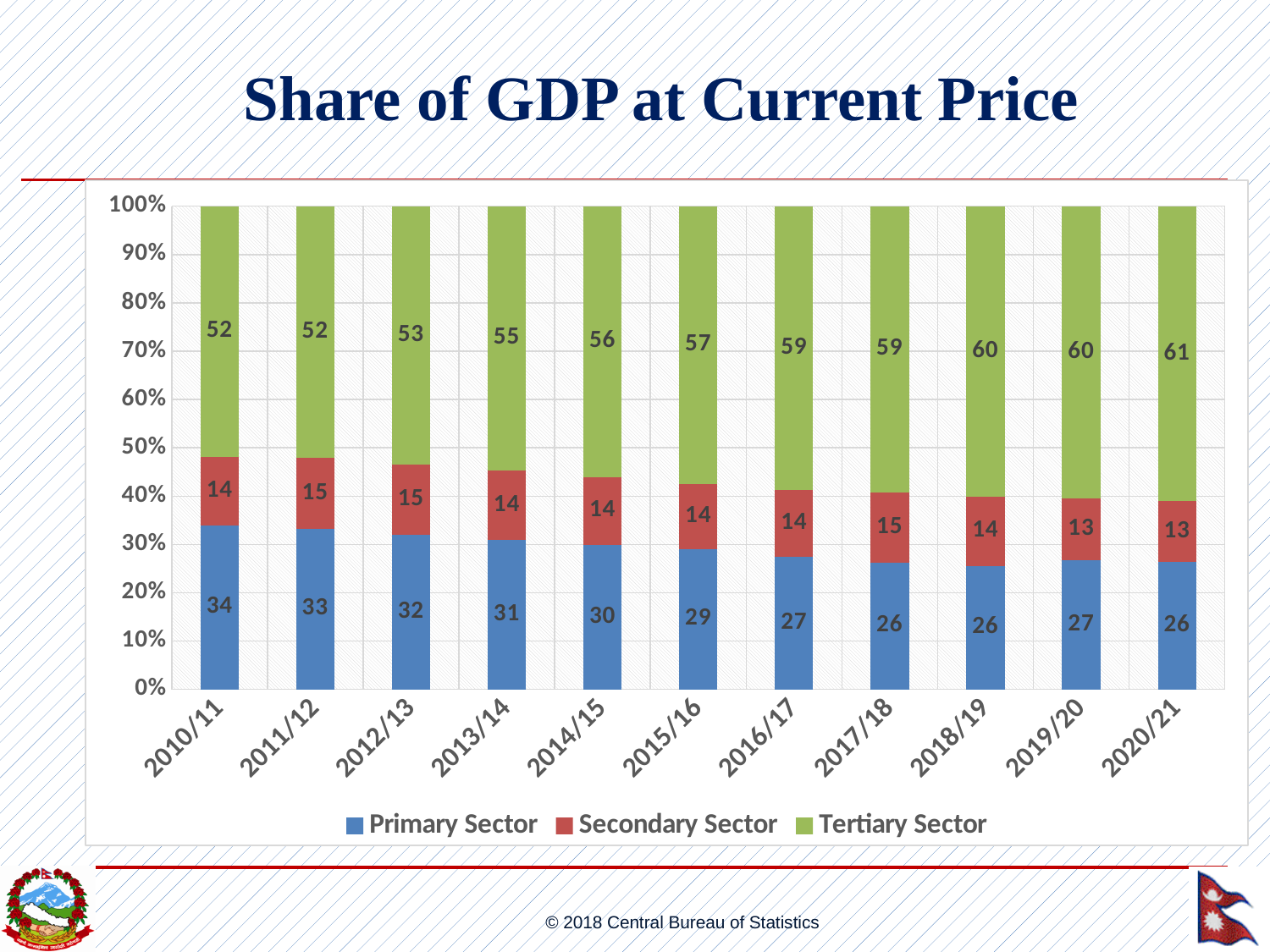
What is the title of the chart? Share of GDP at Current Price What kind of chart is shown on the slide? Stacked bar chart What is the difference between the Tertiary Sector values for 2020/21 and 2010/11? 9 In which year is the Primary Sector value highest? 2010/11 In which year is the Tertiary Sector value highest? 2020/21 How many years are shown on the x axis? 11 What is the Primary Sector value for 2010/11? 34 What is the Tertiary Sector value for 2020/21? 61 What is the Secondary Sector value for 2017/18? 15 How many series does the legend list? 3 Which is larger, the Primary Sector value for 2010/11 or for 2020/21? 2010/11 Does the Tertiary Sector value rise or fall from 2010/11 to 2020/21? Rise